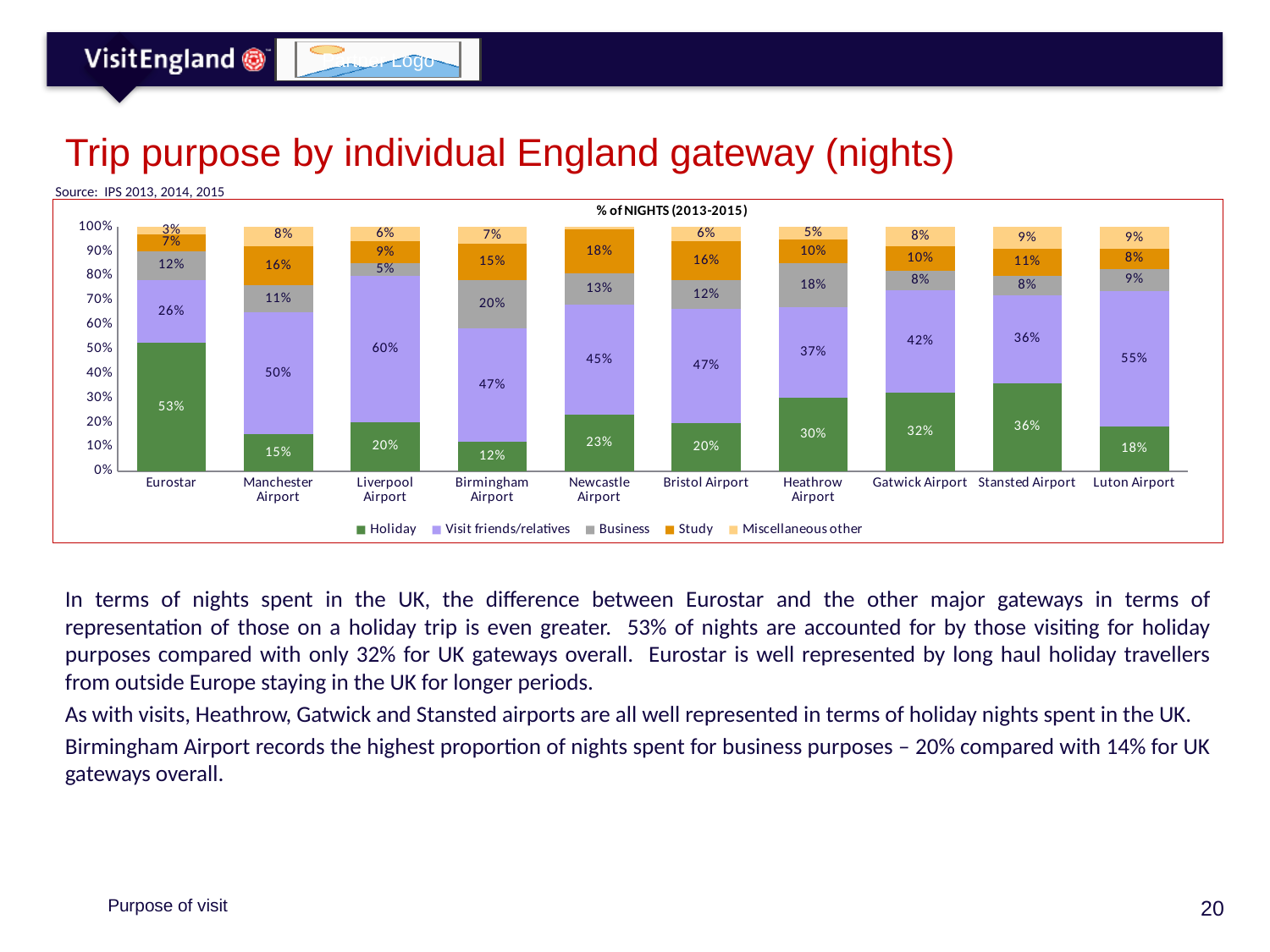
What is the Business share of nights for Birmingham Airport? 20% How many gateways are shown on the chart? 10 What percentage of nights at Eurostar are for Holiday purposes? 53% Which gateway has the highest Visit friends/relatives share of nights? Liverpool Airport What is the Study share of nights for Newcastle Airport? 18% Which has a larger Holiday share of nights, Heathrow Airport or Gatwick Airport? Gatwick Airport How many percentage points higher is the Holiday share for Eurostar than for Manchester Airport? 38 percentage points What is the title of the chart? % of NIGHTS (2013-2015) What kind of chart is shown on the slide? Stacked bar chart Which gateway has the highest Holiday share of nights? Eurostar Which gateway has the lowest Holiday share of nights? Birmingham Airport How many series does the legend list? 5